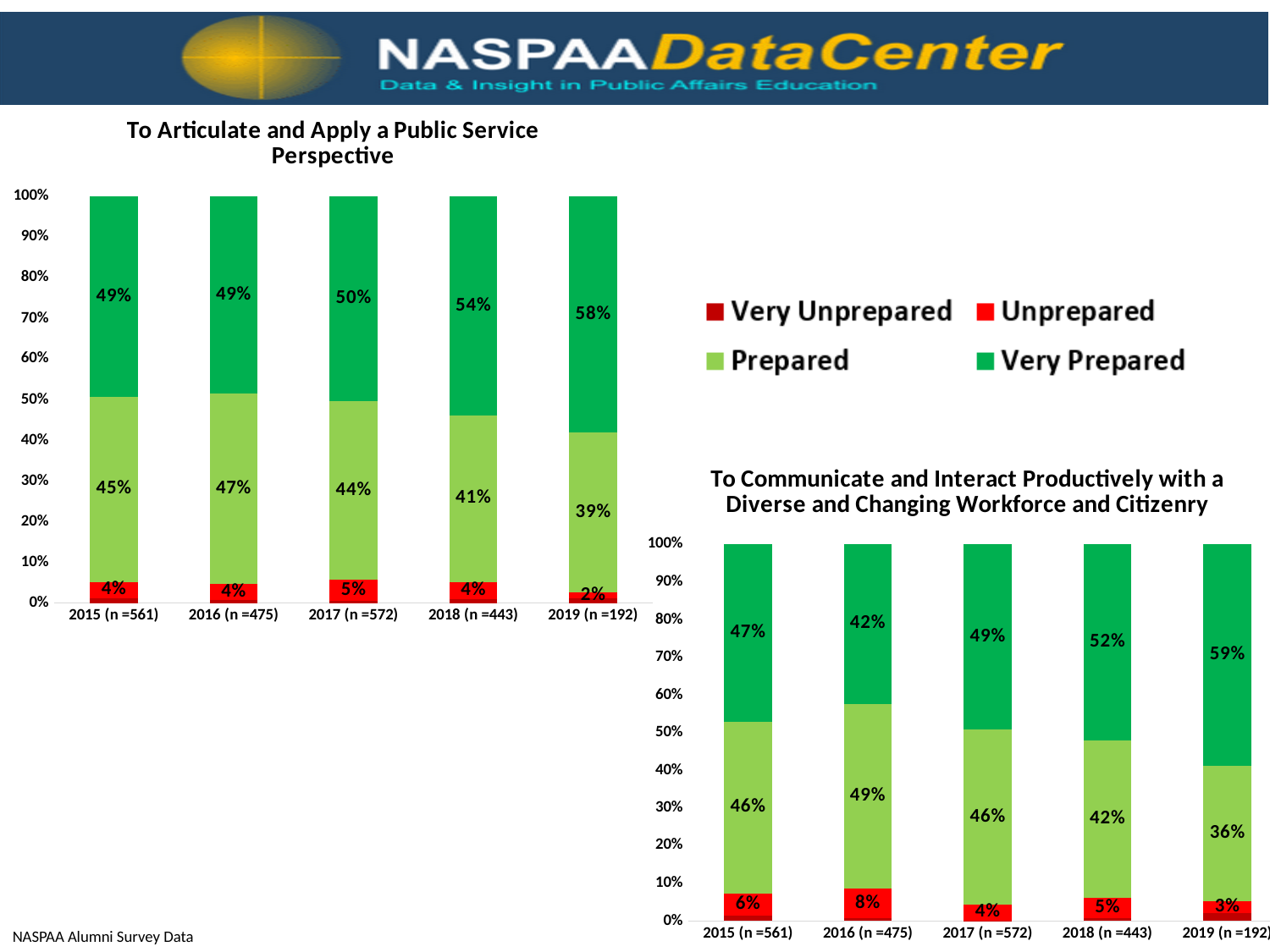
In the 'To Communicate and Interact Productively with a Diverse and Changing Workforce and Citizenry' chart, which year has the highest Unprepared value? 2016 (n =475) In the 'To Articulate and Apply a Public Service Perspective' chart, which year has the highest Very Prepared value? 2019 (n =192) In the 'To Articulate and Apply a Public Service Perspective' chart, which year has the lowest Unprepared value? 2019 (n =192) In the 'To Articulate and Apply a Public Service Perspective' chart, does the Very Prepared value rise or fall from 2015 to 2019? rise In the 'To Articulate and Apply a Public Service Perspective' chart, what is the Very Prepared value for 2019 (n =192)? 58% In the 'To Articulate and Apply a Public Service Perspective' chart, what is the Prepared value for 2016 (n =475)? 47% In the 'To Communicate and Interact Productively with a Diverse and Changing Workforce and Citizenry' chart, what is the difference between the Very Prepared values for 2019 (n =192) and 2018 (n =443)? 7% In the 'To Articulate and Apply a Public Service Perspective' chart, what is the difference between the Very Prepared values for 2019 (n =192) and 2015 (n =561)? 9% What kind of chart is the 'To Articulate and Apply a Public Service Perspective' chart? stacked bar chart How many series does the legend list? 4 In the 'To Communicate and Interact Productively with a Diverse and Changing Workforce and Citizenry' chart, which is larger for 2016 (n =475): the Prepared value or the Very Prepared value? Prepared In the 'To Communicate and Interact Productively with a Diverse and Changing Workforce and Citizenry' chart, what is the Prepared value for 2019 (n =192)? 36%